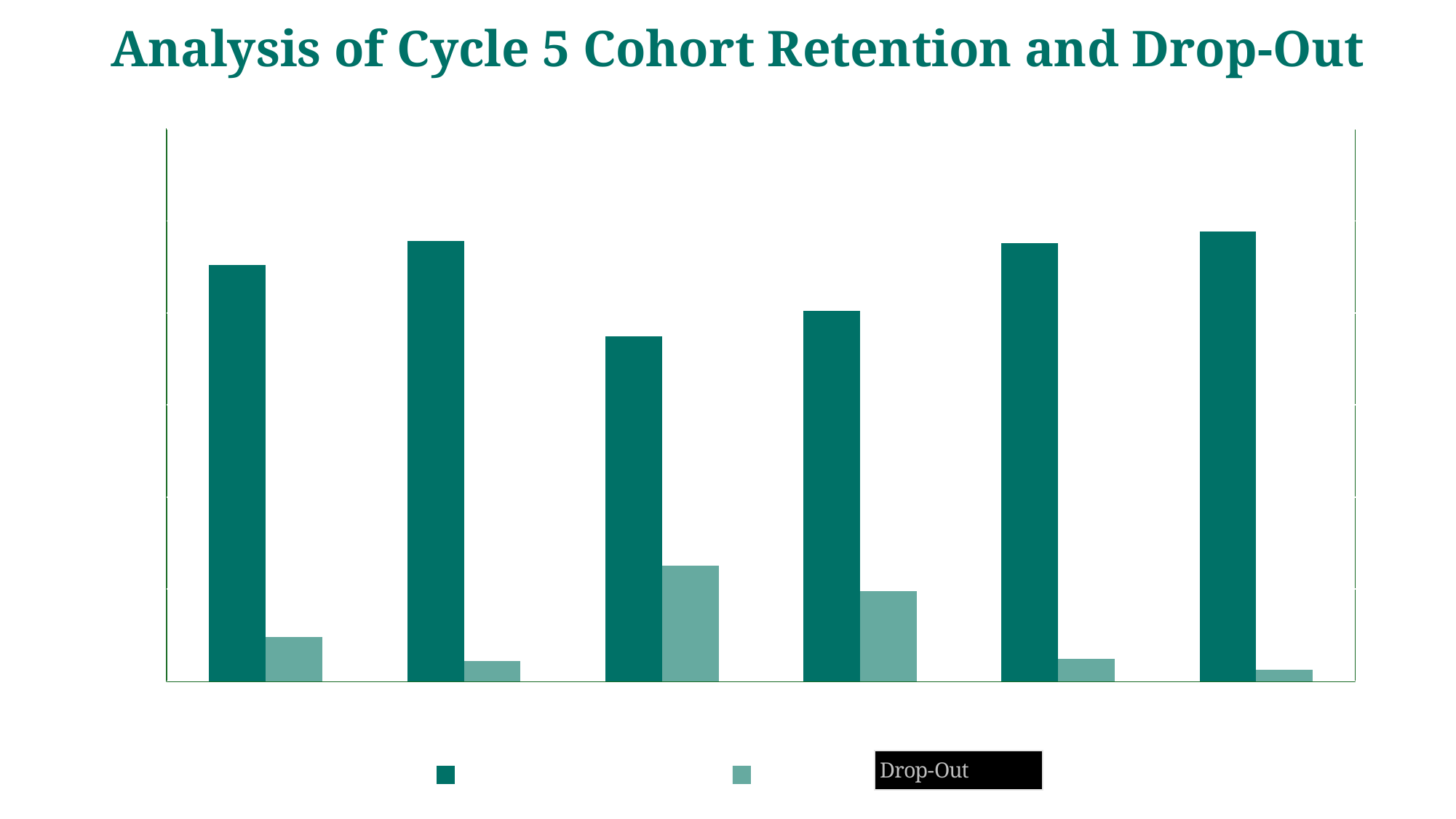
What is the title of the chart? Analysis of Cycle 5 Cohort Retention and Drop-Out How many groups of bars are plotted along the x axis? 6 What kind of chart is shown on the slide? bar chart Which legend entry is readable on the slide? Drop-Out In every group, are the dark teal bars taller or shorter than the light teal bars? taller